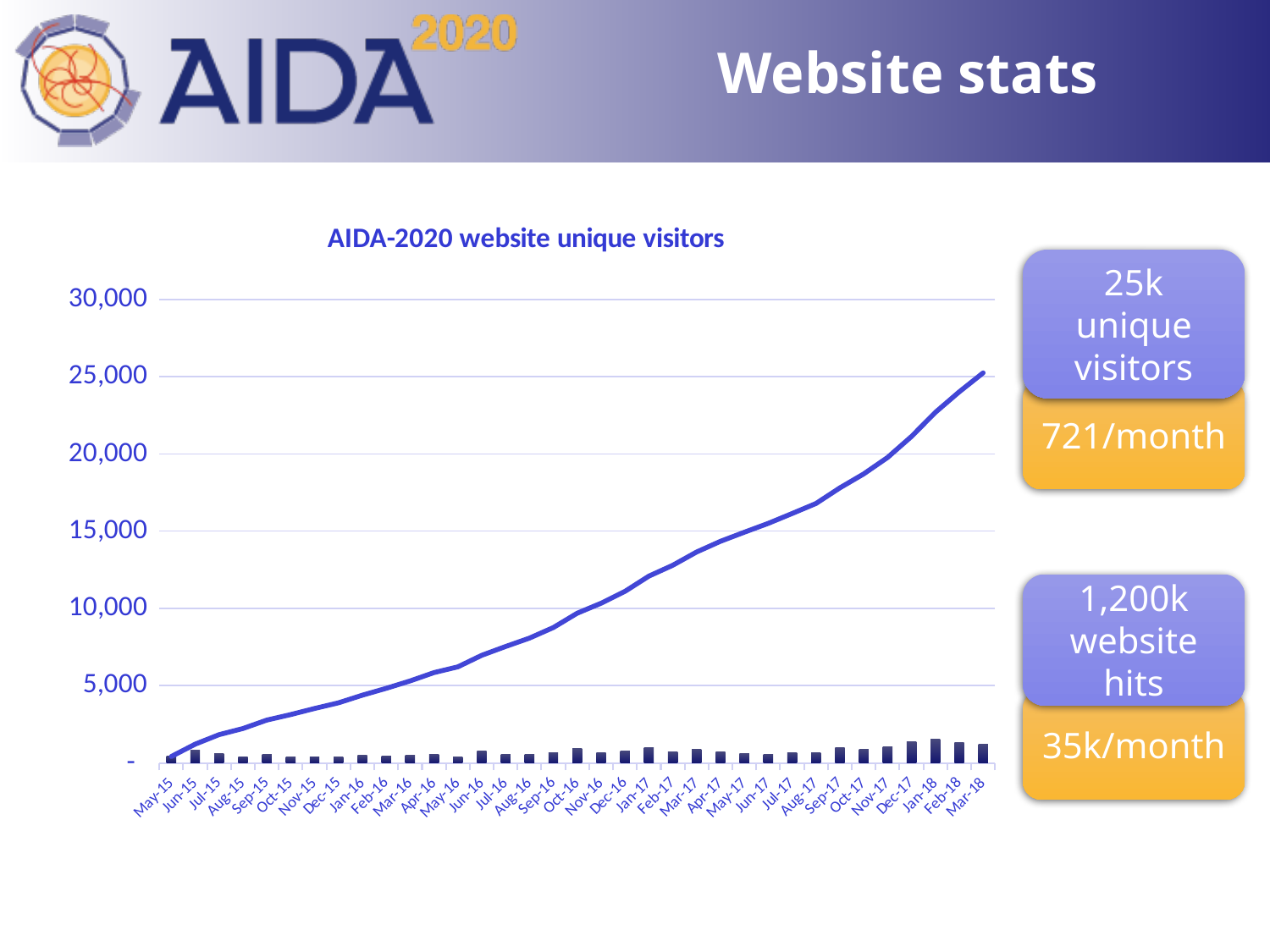
Is the value of the line for Mar-18 greater or less than 20,000? greater What kind of chart is used to show the cumulative unique visitors over time? line chart How many months are shown on the x axis of the chart? 35 What is the title of the chart? AIDA-2020 website unique visitors Which month has the highest value on the unique visitors line? Mar-18 Does the line for unique visitors rise or fall from May-15 to Mar-18? rise Which month has the lowest value on the unique visitors line? May-15 What is the highest value labelled on the y axis of the chart? 30,000 Is the value of the line for Jan-17 greater or less than 10,000? greater Is the value of the line for Dec-15 greater or less than 5,000? less Which is larger on the line: the value for Jan-18 or the value for Jan-17? Jan-18